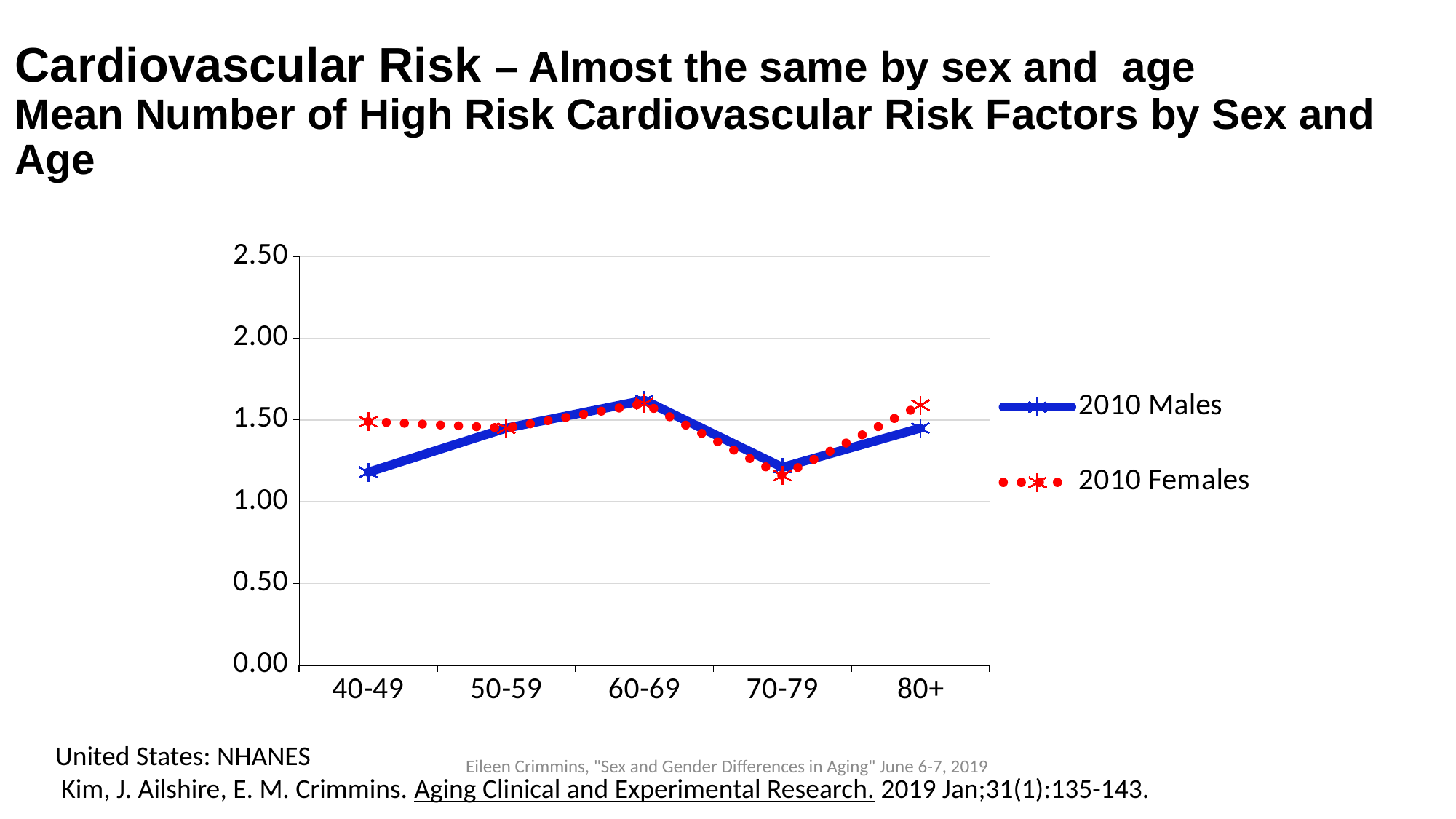
Is the value for 2010 Females at 40-49 greater or less than 1.00? greater What kind of chart is shown on the slide? line chart Is the value for 2010 Males at 60-69 greater or less than 1.50? greater Which series is drawn with a red dotted line? 2010 Females Is the value for 2010 Males at 40-49 greater or less than 1.50? less Do the values for 2010 Males rise or fall from 40-49 to 60-69? rise At age 40-49, which series has the larger value, 2010 Males or 2010 Females? 2010 Females How many series does the legend list? 2 Which age group has the lowest value for 2010 Females? 70-79 How many age groups are shown on the x axis? 5 Which age group has the highest value for 2010 Males? 60-69